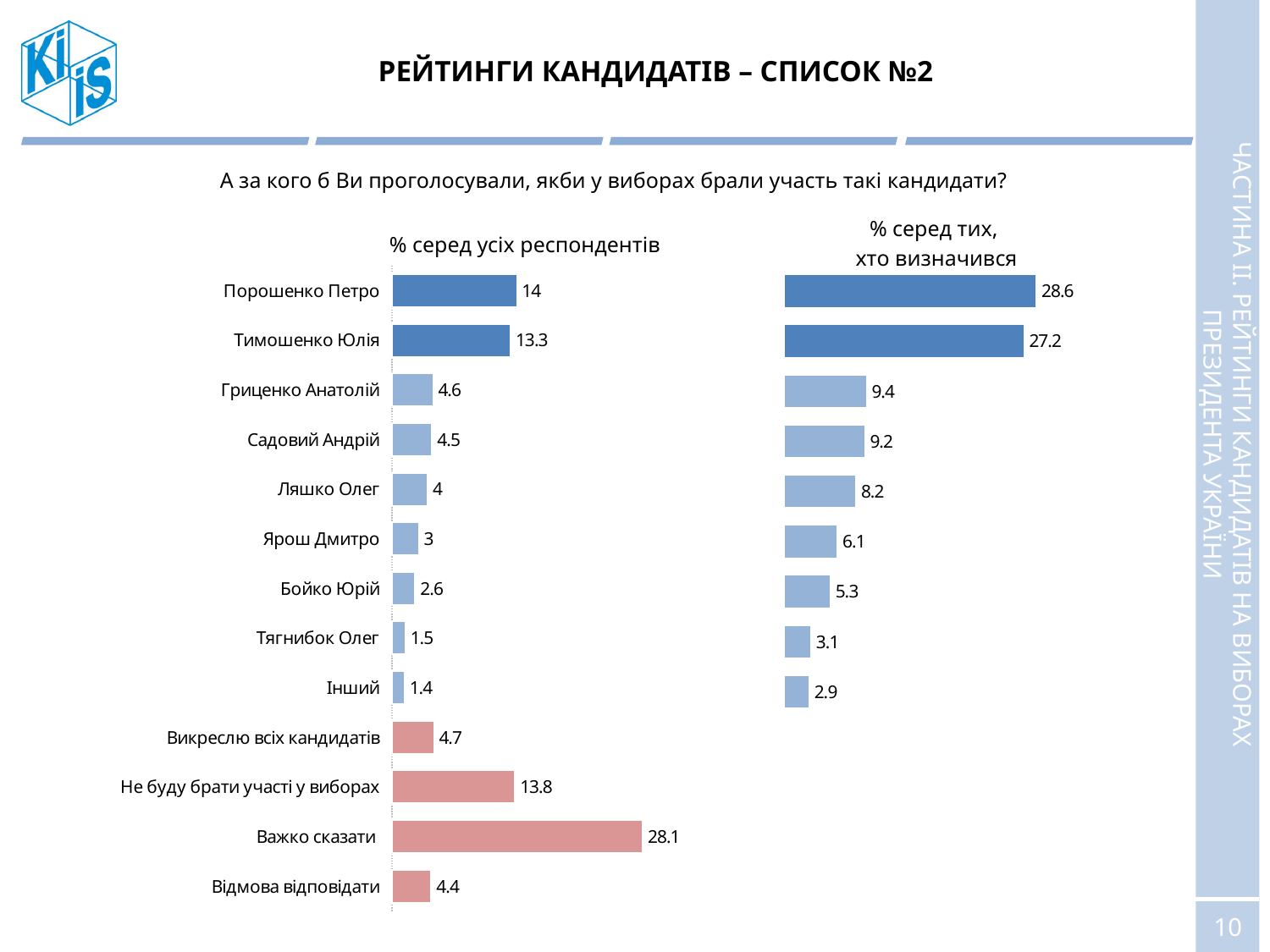
In the chart '% серед усіх респондентів', which is larger: Гриценко Анатолій or Ляшко Олег? Гриценко Анатолій In the chart '% серед тих, хто визначився', what is the value for Тимошенко Юлія? 27.2 In the chart '% серед тих, хто визначився', what is the difference between Порошенко Петро and Тимошенко Юлія? 1.4 In the chart '% серед тих, хто визначився', what is the value for Бойко Юрій? 5.3 How many categories are shown in the chart '% серед усіх респондентів'? 13 In the chart '% серед тих, хто визначився', which category has the highest value? Порошенко Петро How many categories are shown in the chart '% серед тих, хто визначився'? 9 In the chart '% серед усіх респондентів', what is the value for Важко сказати? 28.1 In the chart '% серед усіх респондентів', what is the value for Порошенко Петро? 14 What kind of chart is '% серед тих, хто визначився'? Bar chart In the chart '% серед усіх респондентів', which category has the lowest value? Інший In the chart '% серед усіх респондентів', what is the difference between Не буду брати участі у виборах and Викреслю всіх кандидатів? 9.1